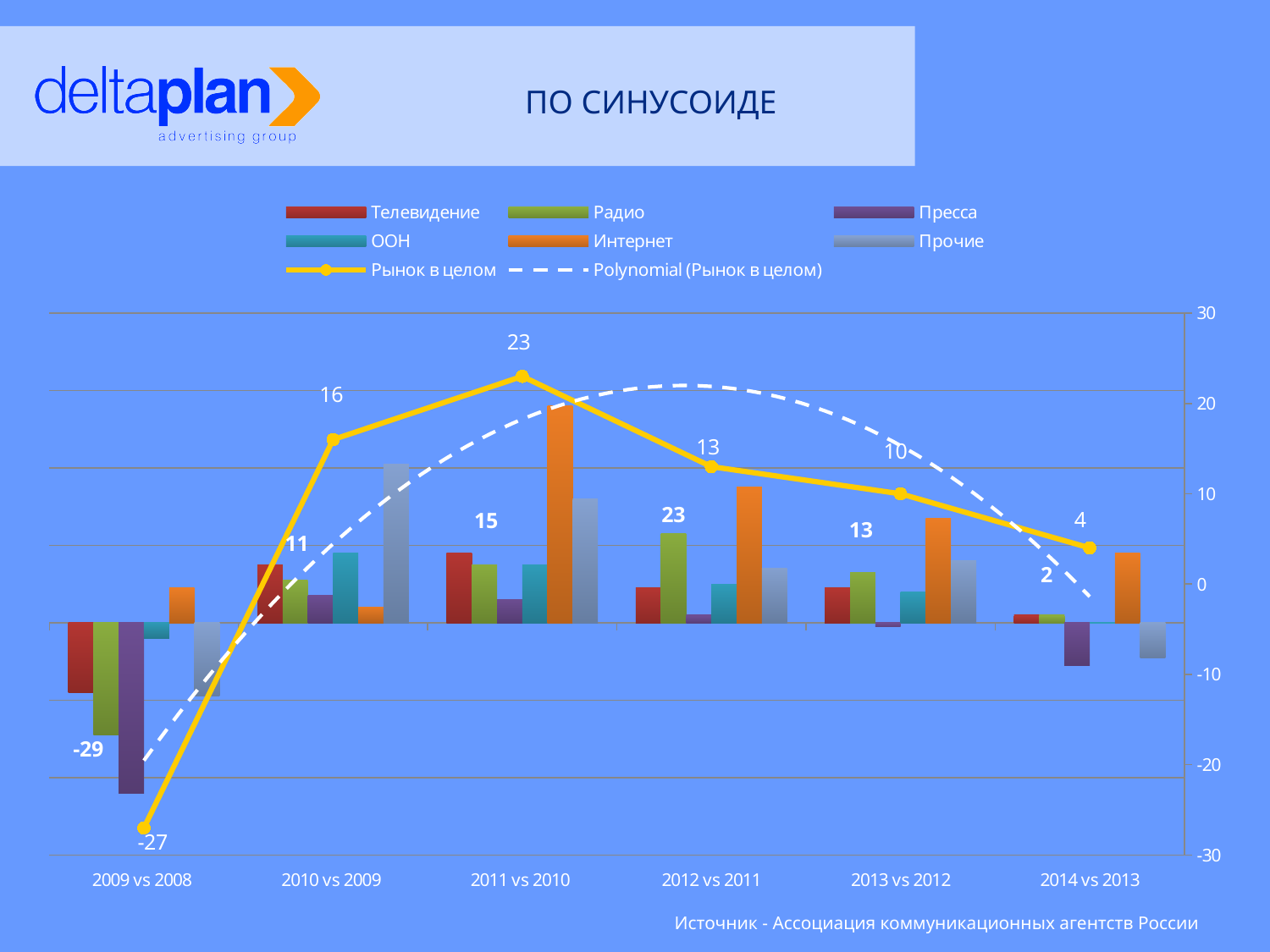
In which period does the Рынок в целом line reach its highest value? 2011 vs 2010 Which is larger: the Рынок в целом value for 2010 vs 2009 or for 2013 vs 2012? 2010 vs 2009 In which period does the Рынок в целом line have its lowest value? 2009 vs 2008 What is the value of the Рынок в целом line for 2014 vs 2013? 4 Does the Рынок в целом line rise or fall from 2011 vs 2010 to 2014 vs 2013? fall Is the Пресса bar for 2009 vs 2008 greater or less than -20? less How many periods are shown on the x axis? 6 What is the value of the Рынок в целом line for 2011 vs 2010? 23 What is the difference between the Рынок в целом values for 2011 vs 2010 and 2010 vs 2009? 7 How many entries does the legend list? 8 Is the Прочие bar for 2010 vs 2009 greater or less than 10? greater What is the value of the Рынок в целом line for 2009 vs 2008? -27